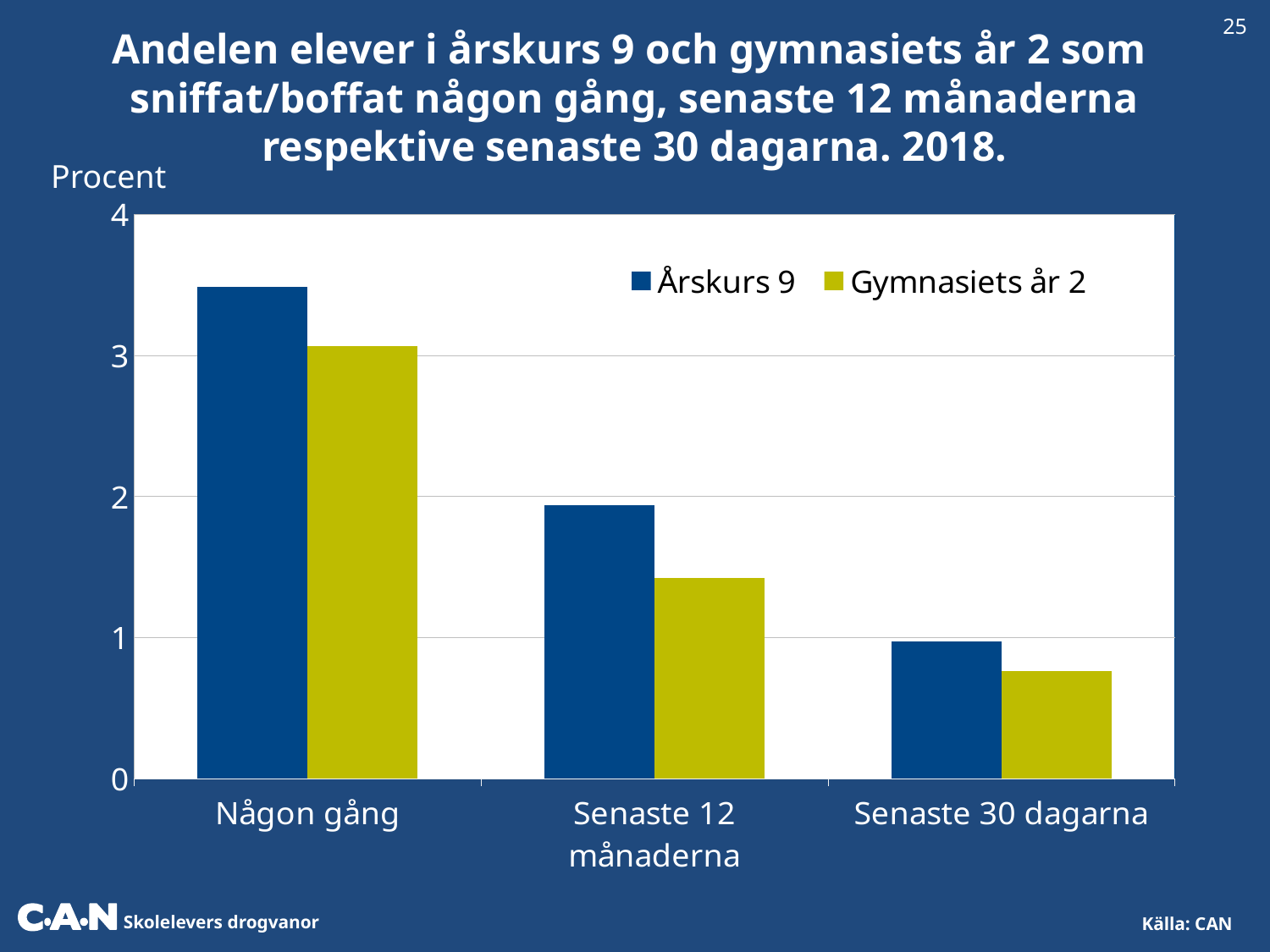
How many series does the legend list? 2 For Någon gång, which series has the larger value: Årskurs 9 or Gymnasiets år 2? Årskurs 9 Which category has the highest value for Årskurs 9? Någon gång What kind of chart is shown on the slide? Bar chart For Senaste 12 månaderna, which series has the larger value: Årskurs 9 or Gymnasiets år 2? Årskurs 9 Do the values for Årskurs 9 rise or fall from Någon gång to Senaste 30 dagarna? Fall Which category has the lowest value for Gymnasiets år 2? Senaste 30 dagarna Is the value for Gymnasiets år 2 in Senaste 30 dagarna greater or less than 1? less Is the value for Årskurs 9 in Någon gång greater or less than 3? greater How many categories are shown on the x axis? 3 What label is shown on the vertical axis of the chart? Procent Is the value for Gymnasiets år 2 in Senaste 12 månaderna greater or less than 2? less